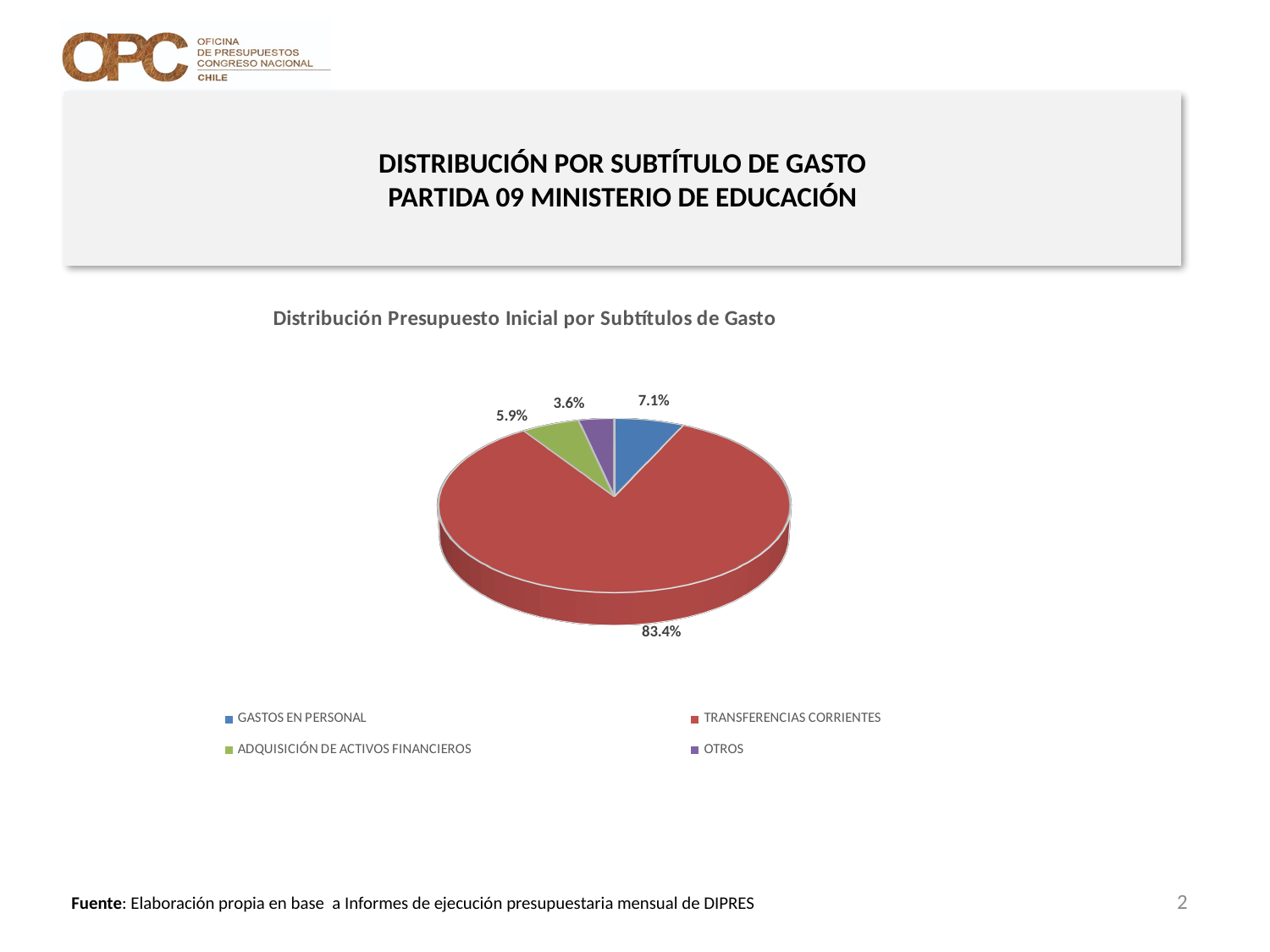
What share of the pie does ADQUISICIÓN DE ACTIVOS FINANCIEROS represent? 5.9% What share of the pie does GASTOS EN PERSONAL represent? 7.1% What is the title of the pie chart? Distribución Presupuesto Inicial por Subtítulos de Gasto What colour is the slice for TRANSFERENCIAS CORRIENTES? Red What kind of chart is shown on the slide? Pie chart What share of the pie does OTROS represent? 3.6% Which category has the largest slice of the pie? TRANSFERENCIAS CORRIENTES Which is larger, the share for GASTOS EN PERSONAL or the share for OTROS? GASTOS EN PERSONAL What is the difference in percentage points between GASTOS EN PERSONAL and ADQUISICIÓN DE ACTIVOS FINANCIEROS? 1.2 How many categories does the pie chart show? 4 Which category has the smallest slice of the pie? OTROS